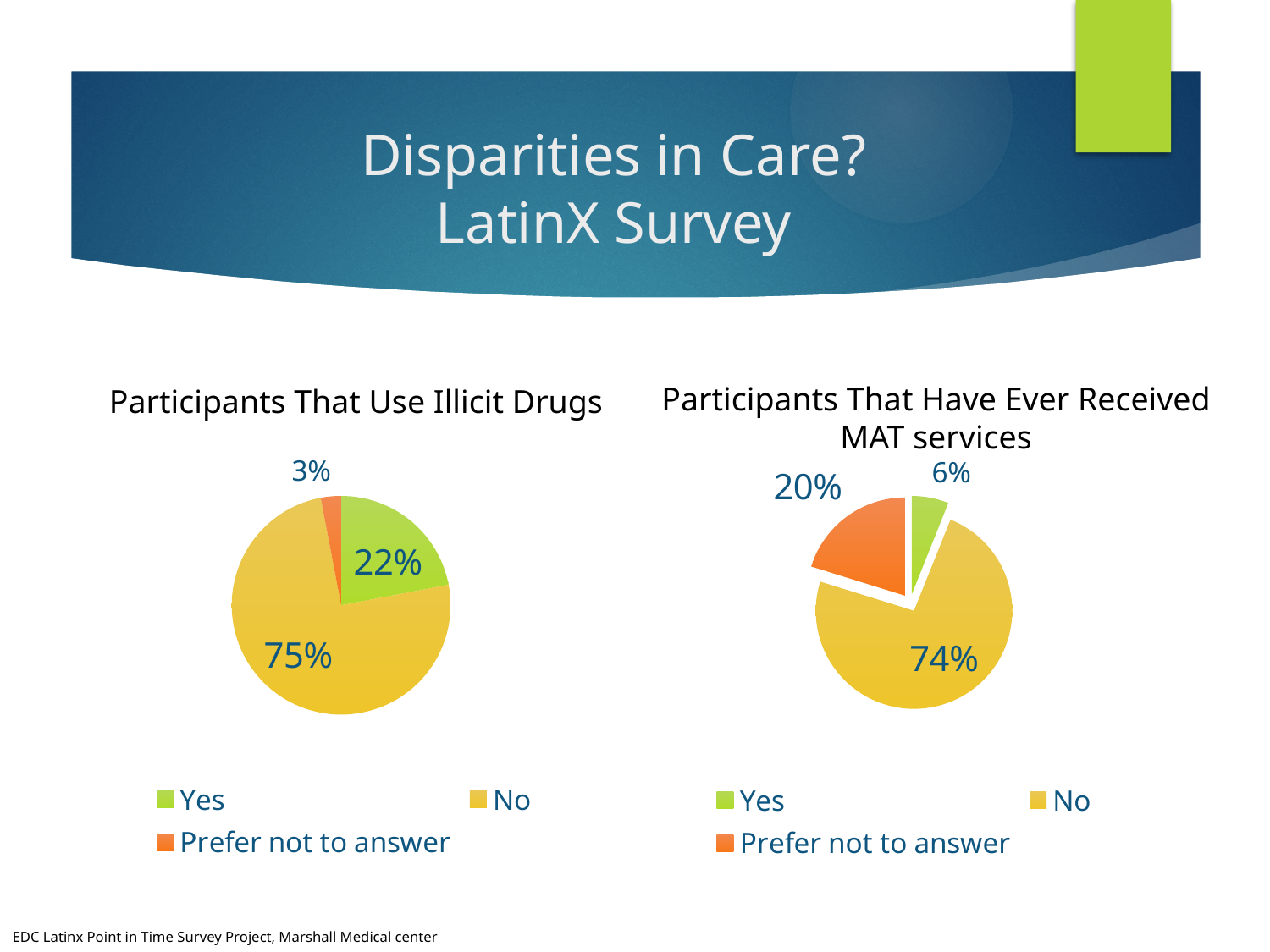
In the 'Participants That Use Illicit Drugs' chart, what percentage answered No? 75% In the 'Participants That Use Illicit Drugs' chart, what percentage chose 'Prefer not to answer'? 3% In the 'Participants That Have Ever Received MAT services' chart, which response has the largest share? No In the 'Participants That Use Illicit Drugs' chart, what is the difference between the No and Yes percentages? 53% In the 'Participants That Have Ever Received MAT services' chart, what percentage answered Yes? 6% In the 'Participants That Have Ever Received MAT services' chart, what percentage chose 'Prefer not to answer'? 20% In the 'Participants That Use Illicit Drugs' chart, what percentage answered Yes? 22% How many categories does the legend of the 'Participants That Have Ever Received MAT services' chart list? 3 In the 'Participants That Use Illicit Drugs' chart, what colour represents the No slice? Yellow In the 'Participants That Have Ever Received MAT services' chart, which is larger: the Yes share or the 'Prefer not to answer' share? Prefer not to answer What type of chart is used for 'Participants That Use Illicit Drugs'? Pie chart In the 'Participants That Use Illicit Drugs' chart, which response has the smallest share? Prefer not to answer